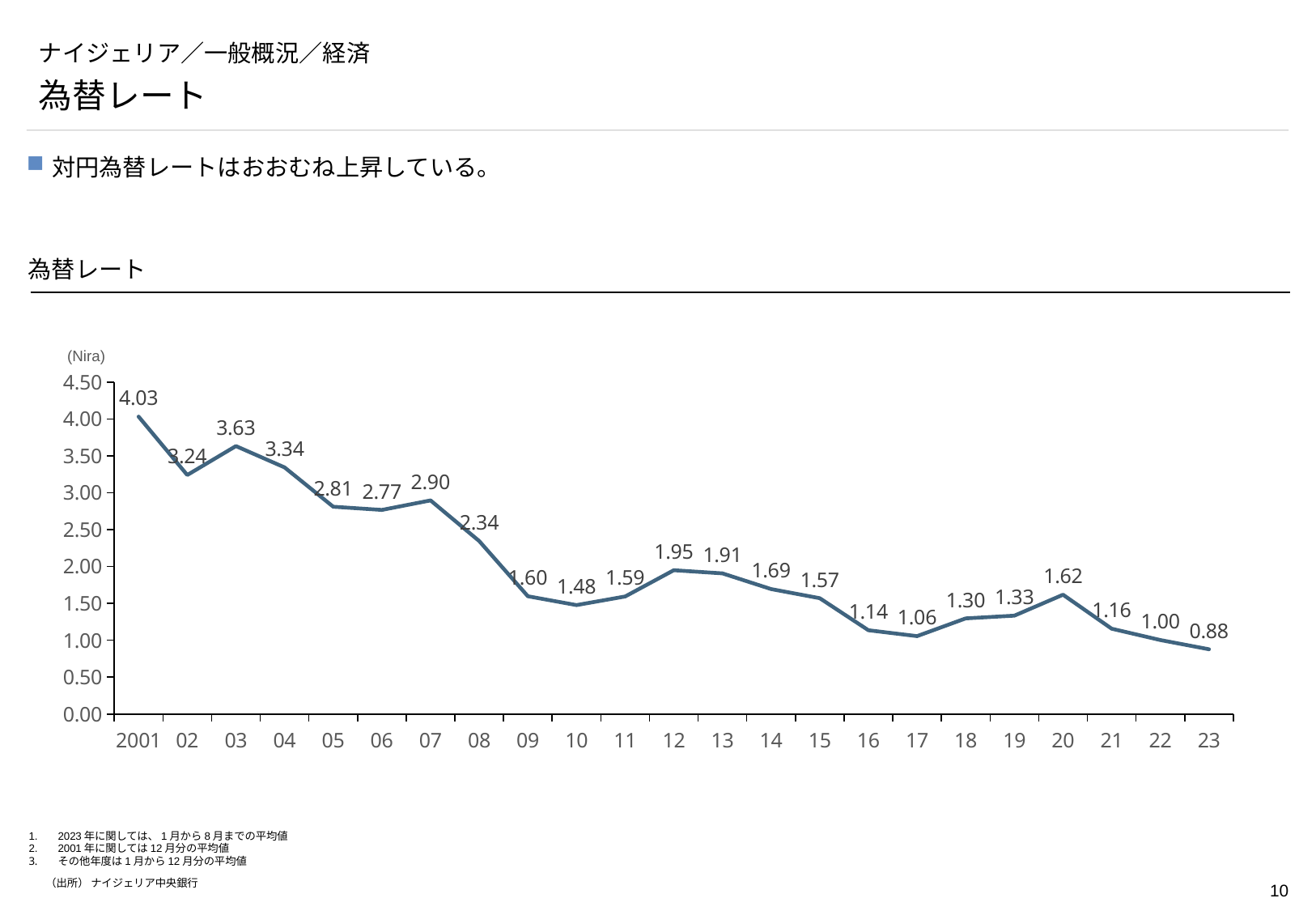
How many data points are plotted on the chart? 23 Which is larger, the value for 03 or the value for 04? 03 What is the exchange rate value for 17? 1.06 Which year has the lowest exchange rate value? 23 What is the exchange rate value for 12? 1.95 What is the difference between the values for 2001 and 23? 3.15 Which year has the highest exchange rate value? 2001 What unit is shown on the vertical axis of the chart? (Nira) Do the values generally rise or fall from 2001 to 23? fall What is the exchange rate value for 23? 0.88 What type of chart is shown on the slide? line chart What is the exchange rate value for 2001? 4.03